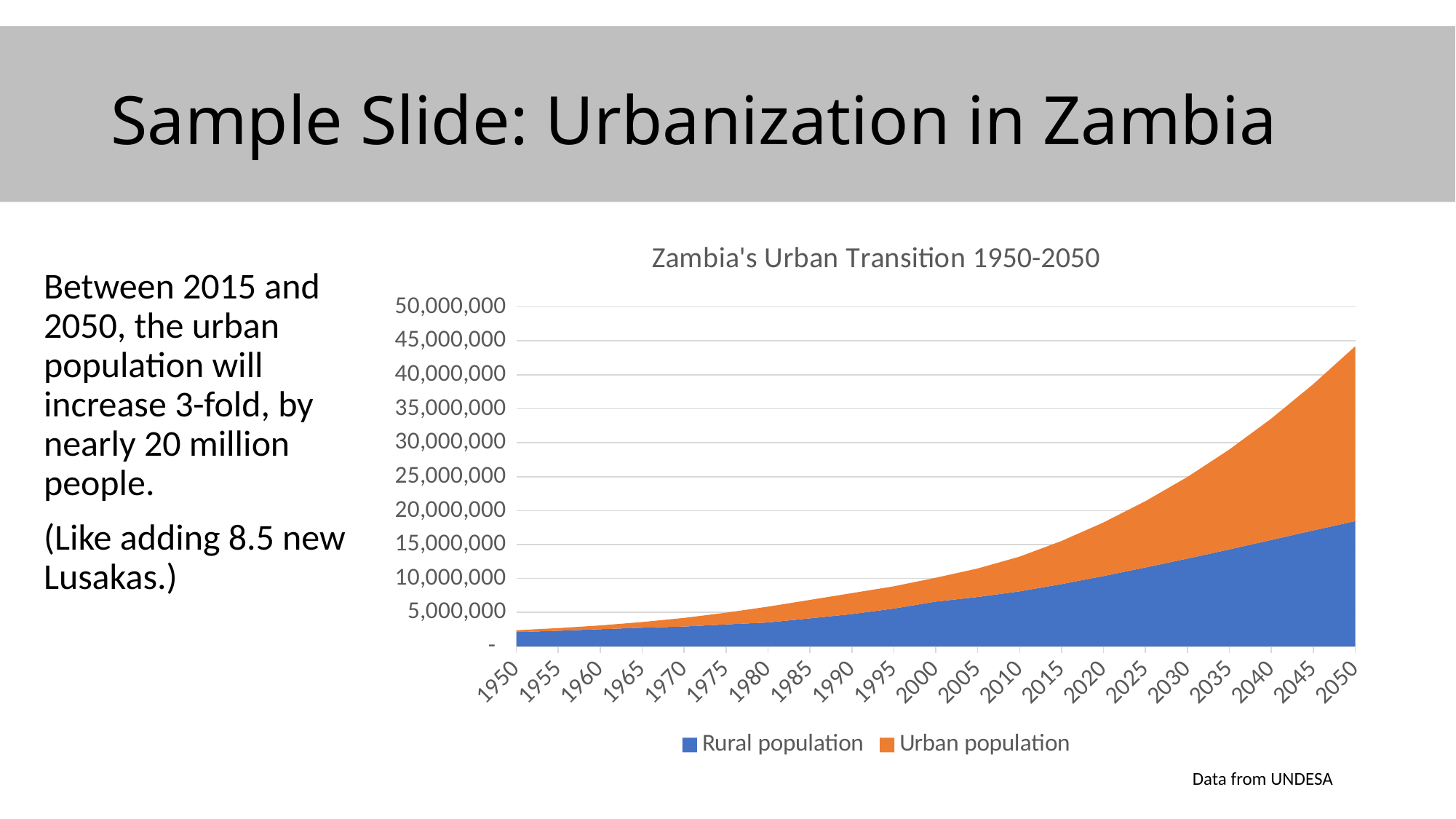
How many years are labelled along the x axis? 21 Is the total population in 1950 greater or less than 5,000,000? less Which year has the highest total population? 2050 What is the title of the chart? Zambia's Urban Transition 1950-2050 How many series does the chart's legend list? 2 What kind of chart is shown on the slide? Stacked area chart Which series is shown in orange? Urban population In 1950, which is larger, the rural population or the urban population? Rural population Which year has the lowest total population? 1950 Is the rural population in 2050 greater or less than 15,000,000? greater Does the total population rise or fall from 1950 to 2050? Rise Is the total population in 2050 greater or less than 40,000,000? greater